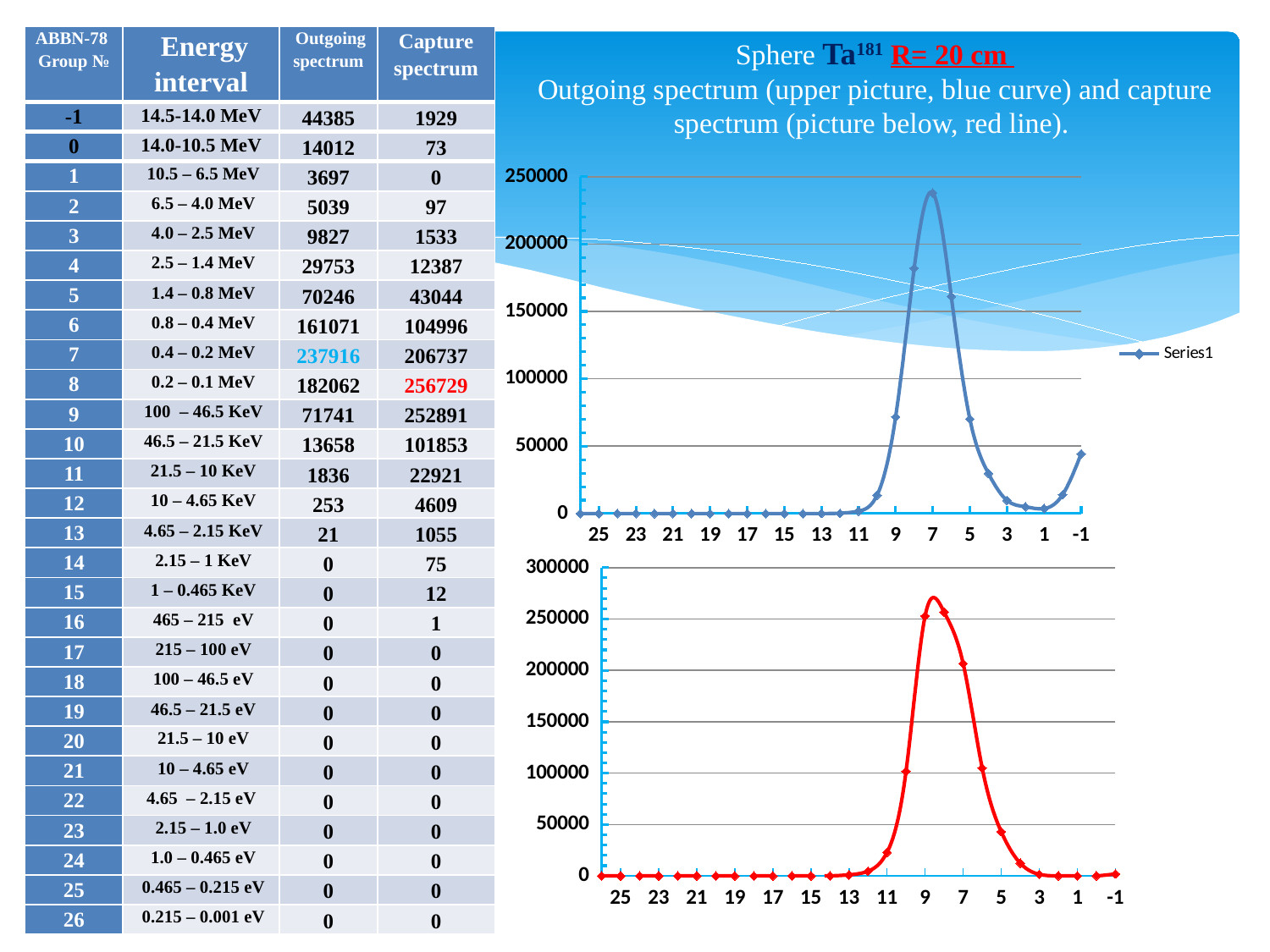
In the upper chart, is the value at category 9 greater or less than 100000? less In the upper chart, at which x-axis category does the curve reach its highest value? 7 What kind of chart is the upper chart on the slide? line chart How many series does the legend of the upper chart list? 1 What kind of chart is the lower chart on the slide? line chart What is the legend entry shown next to the upper chart? Series1 In the lower chart, is the value at category 4 greater or less than 50000? less In the upper chart, is the value at category 7 greater or less than 200000? greater In the upper chart, does the curve rise or fall going from category 7 to category 1? fall